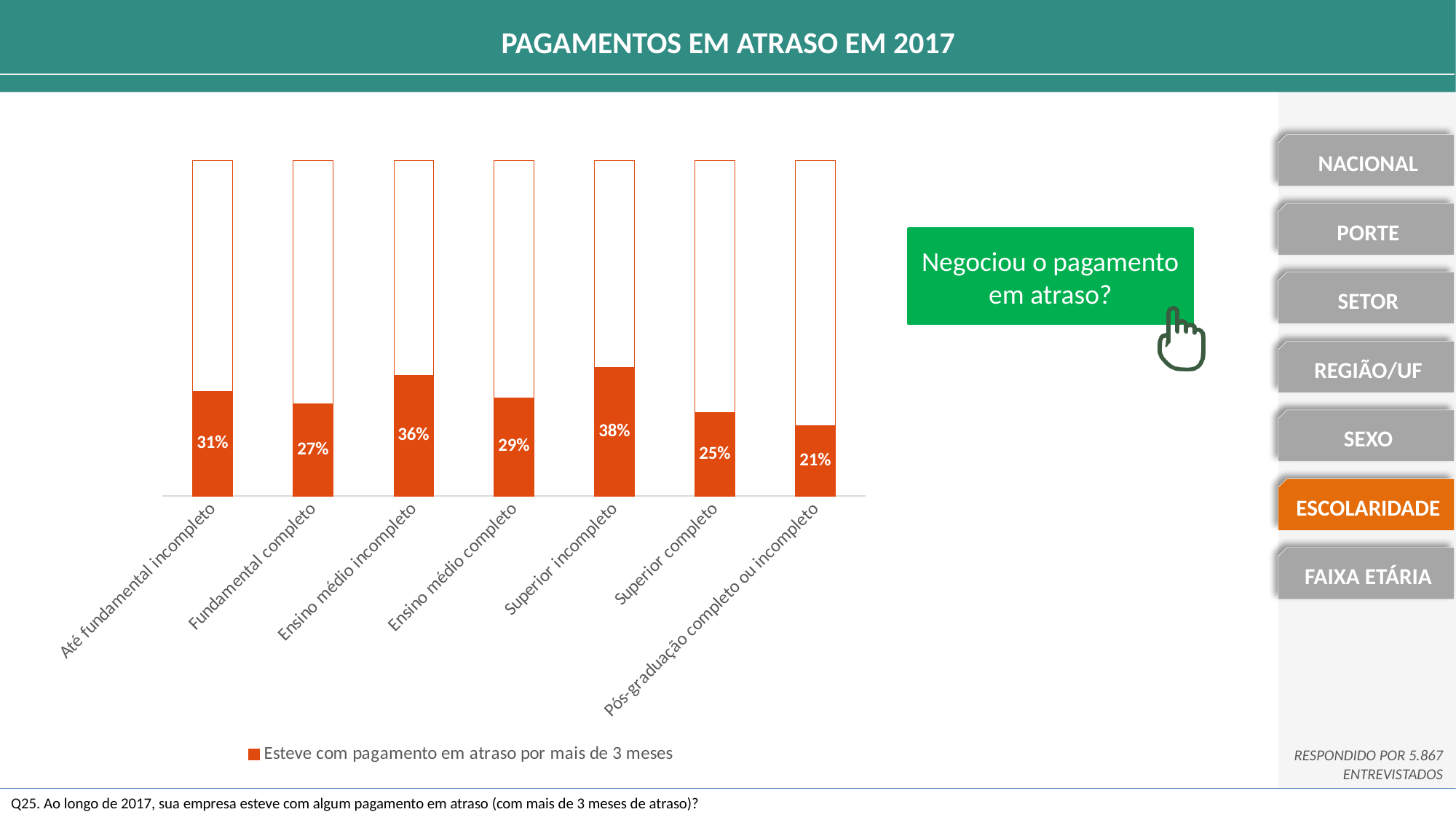
Which is larger, the value for Até fundamental incompleto or the value for Fundamental completo? Até fundamental incompleto How many categories are shown on the x axis? 7 What is the title of the slide? PAGAMENTOS EM ATRASO EM 2017 What is the value for Ensino médio completo? 29% Which category has the highest value? Superior incompleto How many series does the legend list? 1 What is the value for Pós-graduação completo ou incompleto? 21% Which category has the lowest value? Pós-graduação completo ou incompleto What is the legend entry for the orange series? Esteve com pagamento em atraso por mais de 3 meses What is the difference between the values for Superior incompleto and Superior completo? 13% What is the value for Superior incompleto? 38% What kind of chart is shown? Bar chart